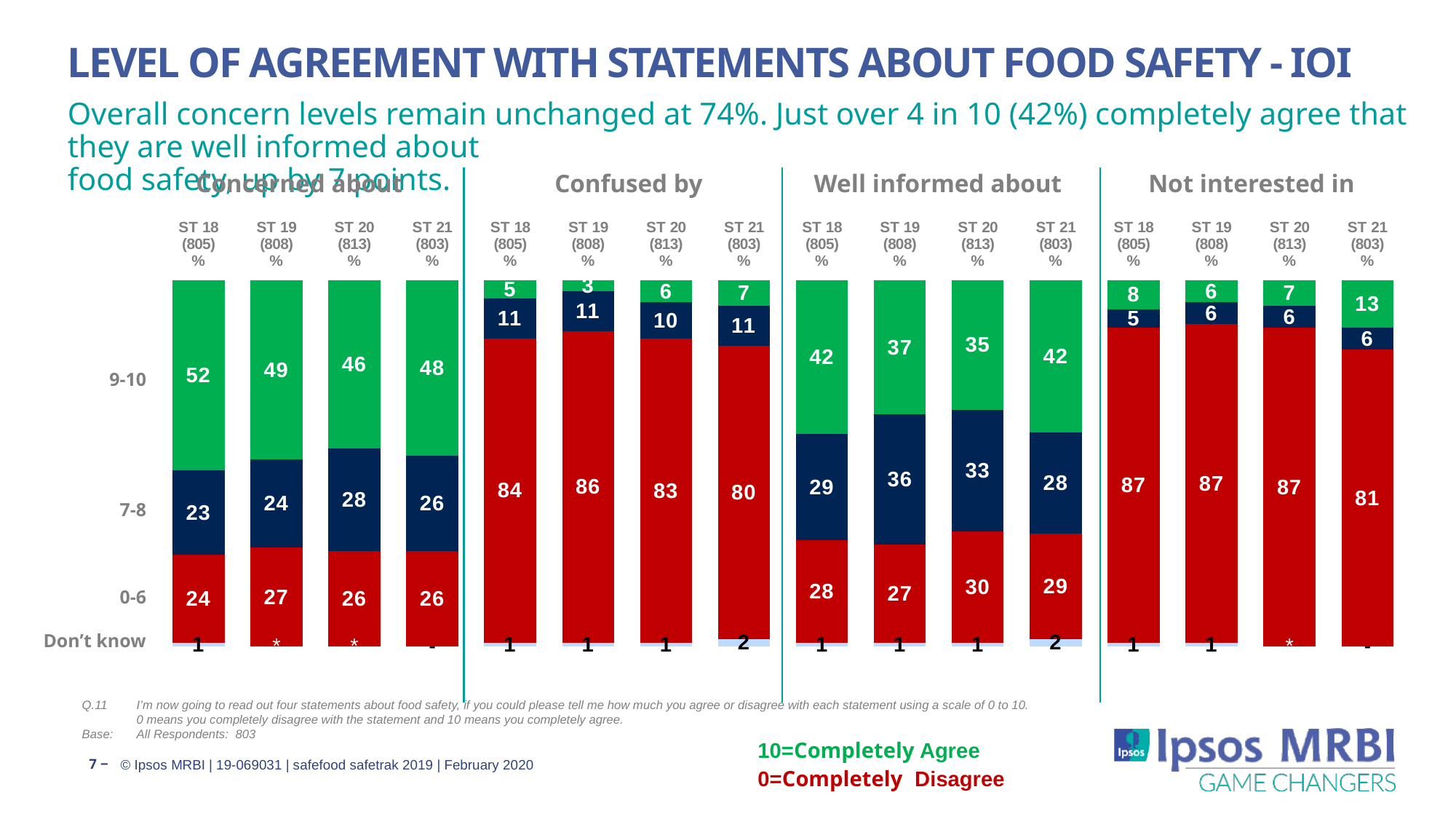
Which colour represents the 9-10 rating in the charts? Green In the 'Well informed about' chart, by how many points is the 9-10 percentage in ST 21 higher than in ST 20? 7 In the 'Confused by' chart, does the 0-6 percentage rise or fall from ST 19 to ST 21? Fall In the 'Confused by' chart, which wave has the lowest 9-10 percentage? ST 19 In the 'Not interested in' chart, which wave has the larger 0-6 percentage, ST 18 or ST 21? ST 18 In the 'Not interested in' chart, what percentage gave a 9-10 rating in ST 21? 13 What kind of chart is used on this slide? Stacked bar chart In the 'Concerned about' chart, what percentage gave a 9-10 rating in ST 21? 48 In the 'Confused by' chart, what percentage gave a 0-6 rating in ST 19? 86 How many survey waves are shown in the 'Concerned about' chart? 4 In the 'Well informed about' chart, what percentage gave a 7-8 rating in ST 20? 33 In the 'Concerned about' chart, which wave has the highest 9-10 percentage? ST 18